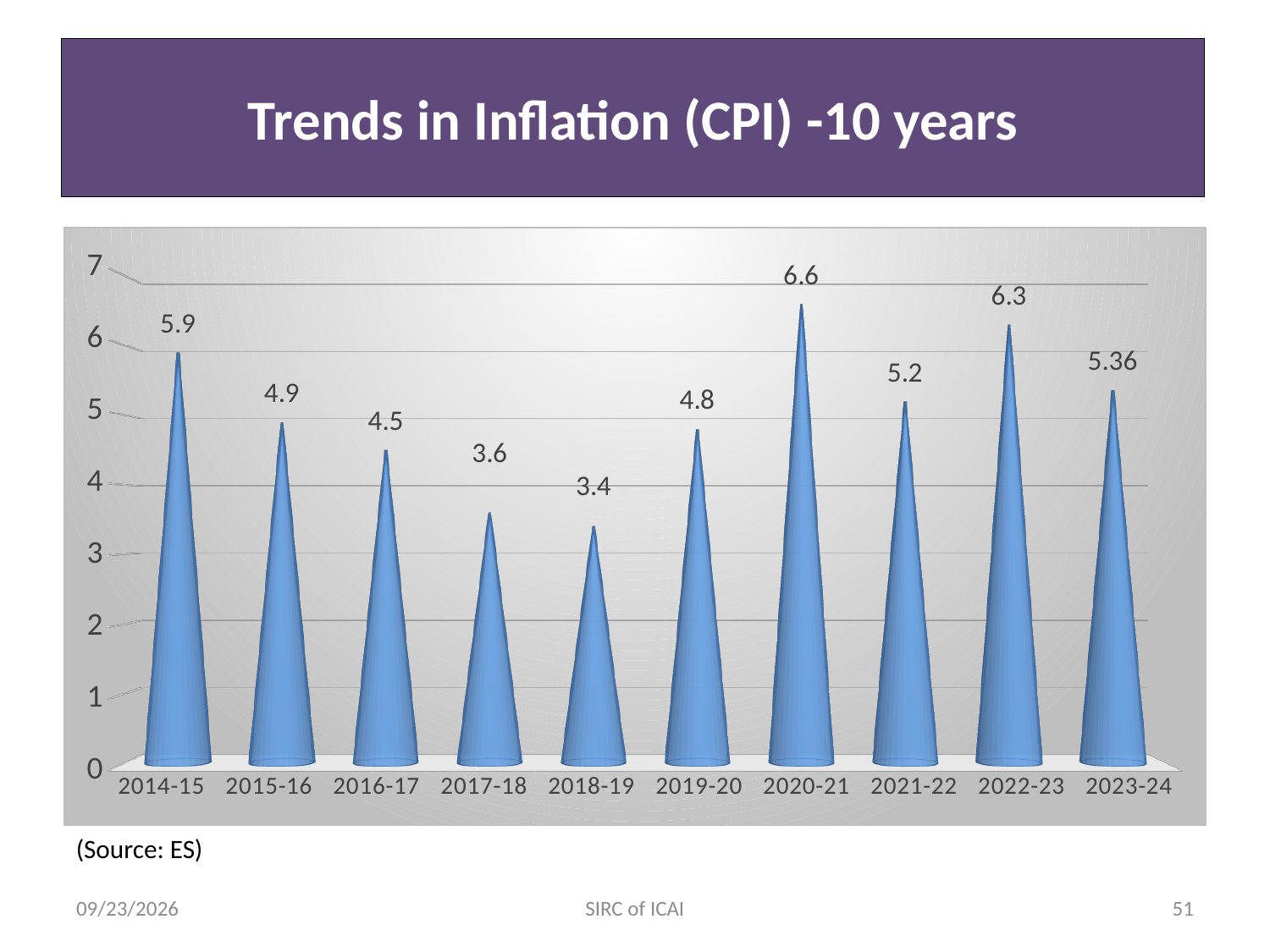
What is the CPI inflation value for 2023-24? 5.36 What is the title of the chart? Trends in Inflation (CPI) -10 years Which is larger, the CPI inflation value for 2015-16 or for 2019-20? 2015-16 What kind of chart is shown on the slide? bar chart Do the CPI inflation values rise or fall from 2014-15 to 2018-19? fall What is the CPI inflation value for 2018-19? 3.4 How many years are shown on the chart? 10 What is the CPI inflation value for 2014-15? 5.9 Is the CPI inflation value for 2022-23 greater or less than 6? greater What is the difference between the CPI inflation values for 2020-21 and 2018-19? 3.2 Which year has the lowest CPI inflation value? 2018-19 Which year has the highest CPI inflation value? 2020-21